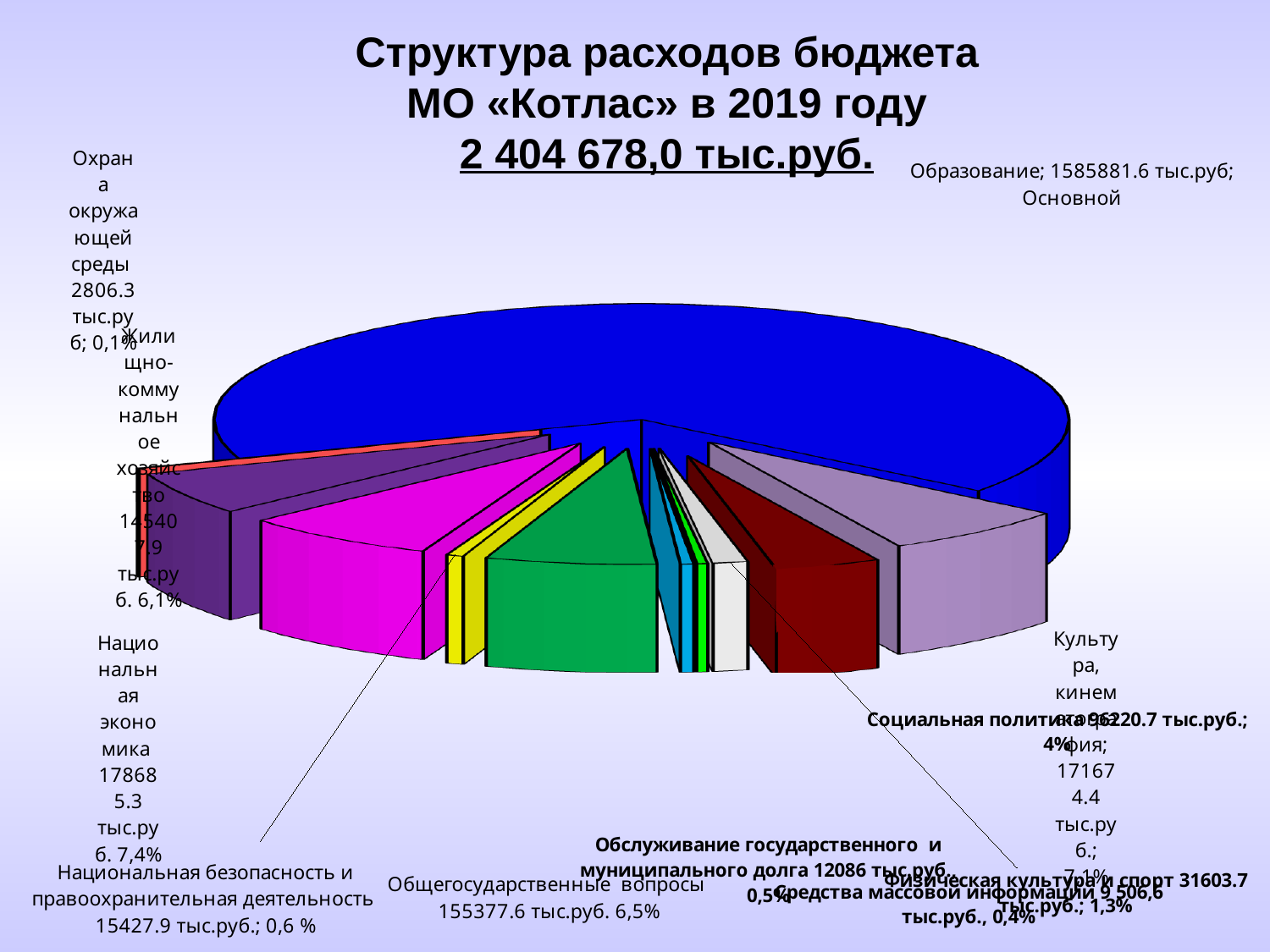
Which is larger: the expenditure for Национальная экономика or for Жилищно-коммунальное хозяйство? Национальная экономика Which category has the largest share of the budget expenditure? Образование Which category has the smallest expenditure value? Охрана окружающей среды What share of the budget goes to Национальная экономика? 7,4% What total budget expenditure is stated in the chart title? 2 404 678,0 тыс.руб. What is the expenditure value for Образование? 1585881.6 тыс.руб What colour is the slice for Образование? blue What share of the budget goes to Физическая культура и спорт? 1,3% What kind of chart is shown on the slide? pie chart How many expenditure categories are shown in the pie chart? 11 What is the difference between the expenditure for Общегосударственные вопросы and for Жилищно-коммунальное хозяйство, in тыс.руб.? 9969.7 What is the expenditure value for Социальная политика? 96220.7 тыс.руб.